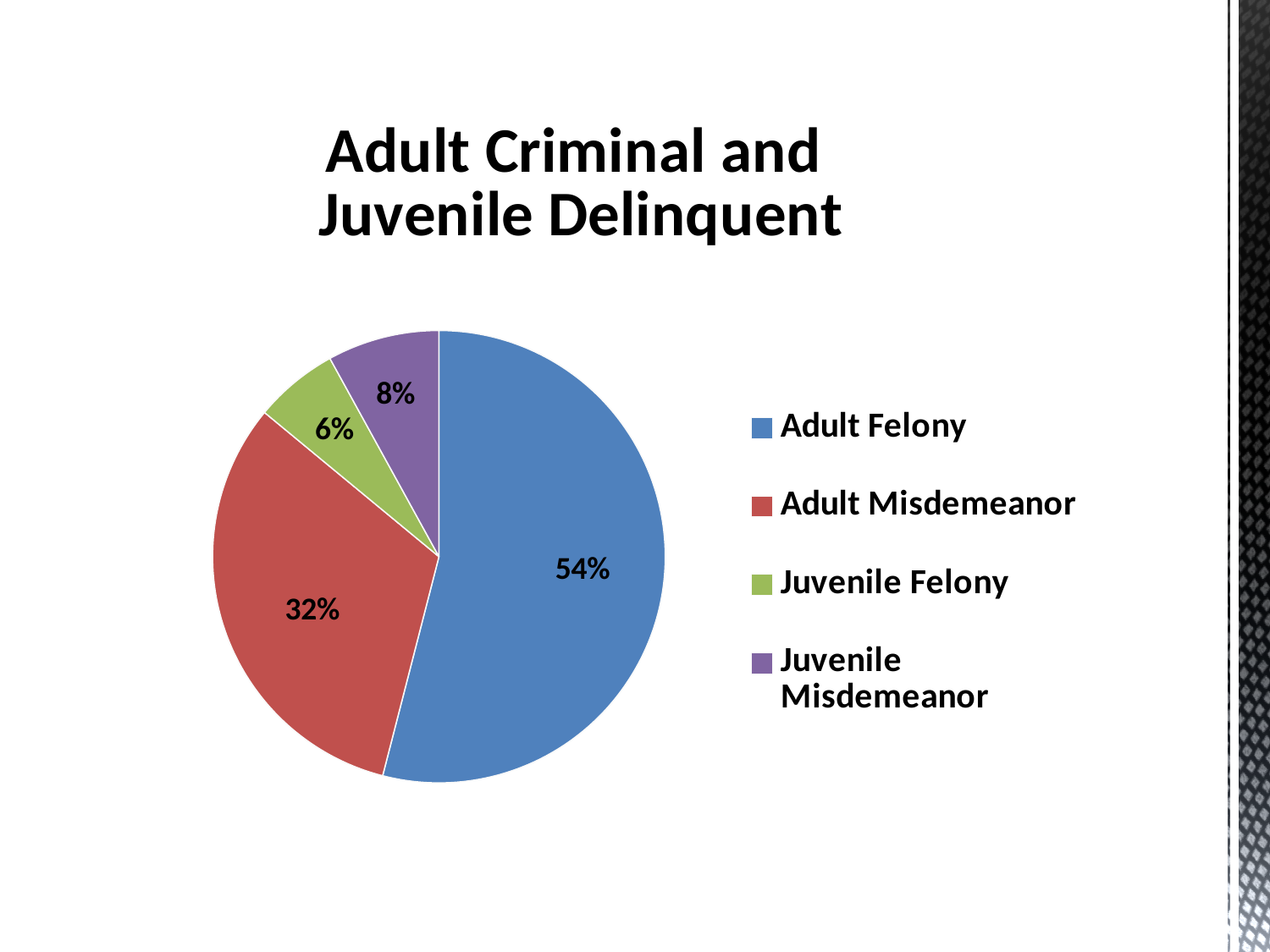
What share of the pie is Juvenile Misdemeanor? 8% How many categories does the pie chart have? 4 What colour is the Adult Misdemeanor slice? red What is the title of the chart? Adult Criminal and Juvenile Delinquent What share of the pie is Adult Misdemeanor? 32% What is the difference in percentage points between Adult Felony and Adult Misdemeanor? 22 What kind of chart is shown on the slide? pie chart What share of the pie is Juvenile Felony? 6% Which is larger, Juvenile Misdemeanor or Juvenile Felony? Juvenile Misdemeanor Which category has the smallest slice of the pie? Juvenile Felony Which category has the largest slice of the pie? Adult Felony